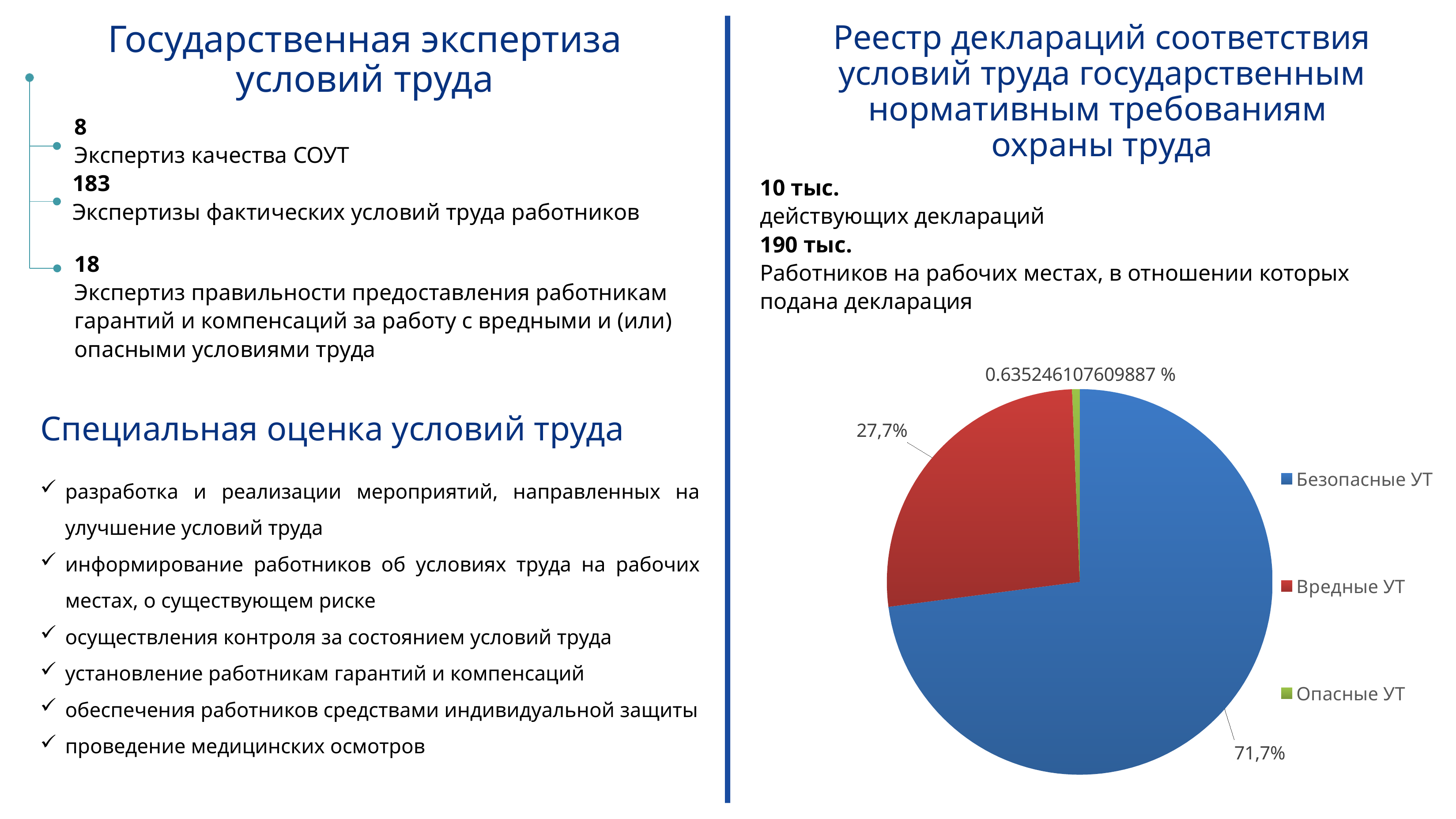
Which is larger, the slice for Вредные УТ or the slice for Опасные УТ? Вредные УТ What share of the pie does Вредные УТ have? 27,7% Which category has the smallest slice of the pie? Опасные УТ What colour is the slice for Безопасные УТ? blue How many slices does the pie chart have? 3 What kind of chart is shown on the slide? pie chart What share of the pie does Безопасные УТ have? 71,7% What is the difference in percentage points between the Безопасные УТ slice and the Вредные УТ slice? 44,0 percentage points How many entries does the legend of the pie chart list? 3 What value is labelled for Опасные УТ on the pie chart? 0.635246107609887 % Which category has the largest slice of the pie? Безопасные УТ What colour is the slice for Вредные УТ? red